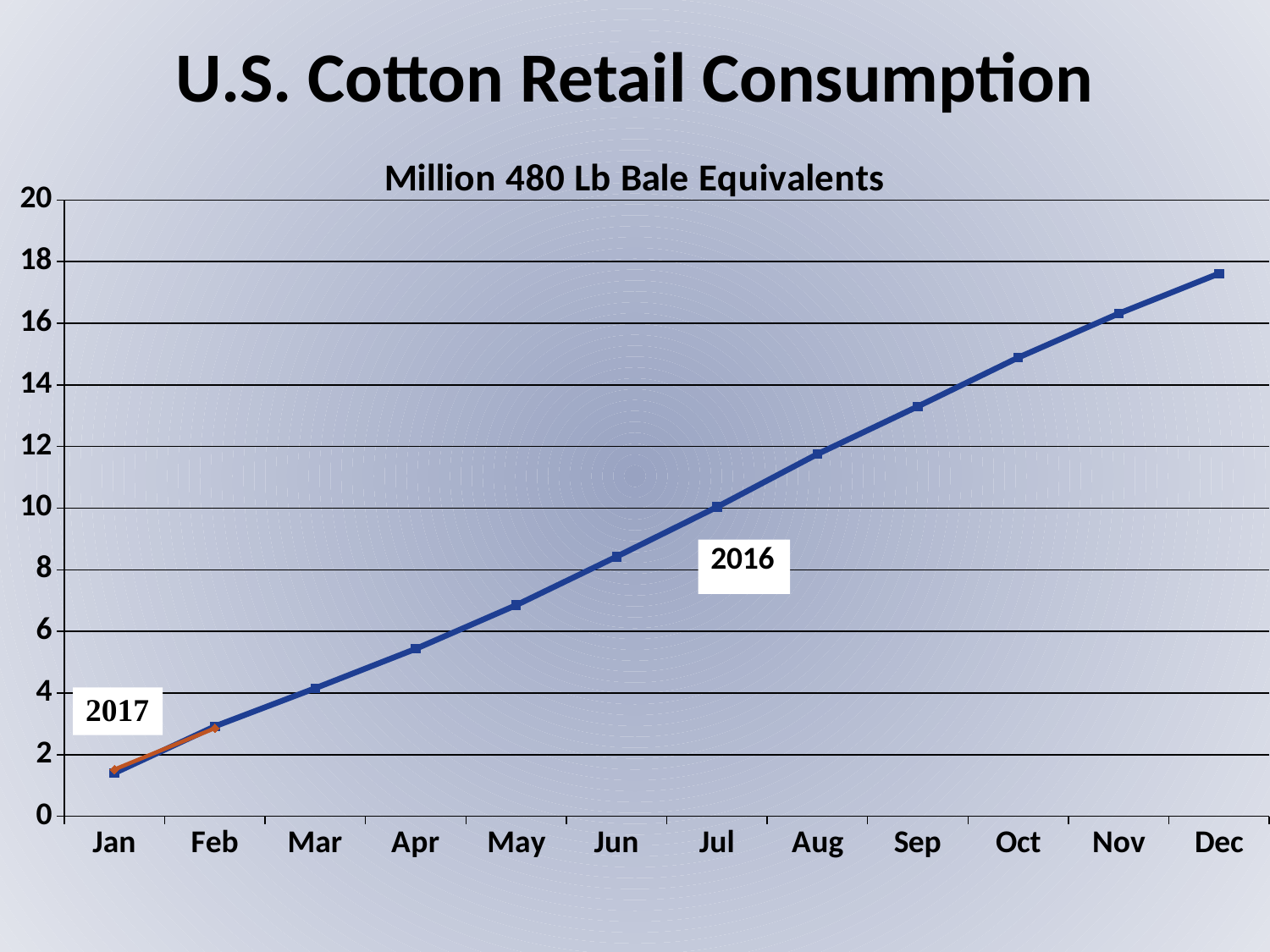
Is the 2016 value for Sep greater or less than 12? greater In which month is the 2016 value lowest? Jan Which is larger for 2016, the value for Oct or the value for Jun? Oct What kind of chart is shown on the slide? line chart Is the 2016 value for Dec greater or less than 16? greater How many data series (years) are plotted on the chart? 2 Is the 2016 value for Apr greater or less than 6? less What unit is given in the chart's subtitle? Million 480 Lb Bale Equivalents Does the 2016 line rise or fall from Jan to Dec? rise In which month is the 2016 value highest? Dec How many months are shown on the x axis? 12 What is the title of the chart? U.S. Cotton Retail Consumption